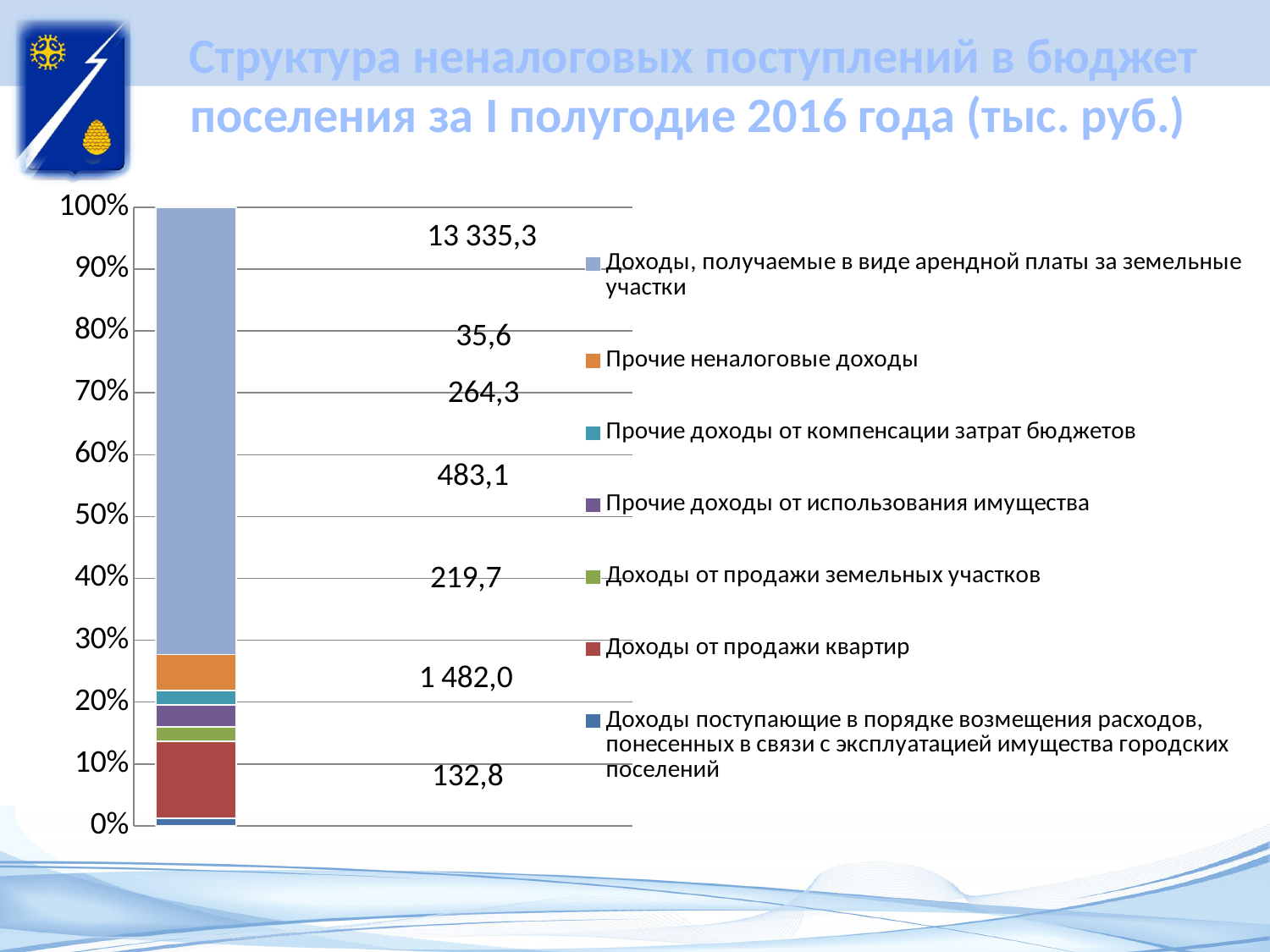
What is the total of all seven values printed on the chart? 15 952,8 Which legend entry is shown in orange? Прочие неналоговые доходы What is the difference between the values 1 482,0 and 132,8? 1 349,2 Which is larger: the value 1 482,0 or the value 483,1? 1 482,0 What value is printed for 'Прочие доходы от использования имущества'? 483,1 What is the largest value printed on the chart? 13 335,3 How many bars are plotted in the chart? 1 What kind of chart is shown on the slide? Stacked bar chart How many series does the legend list? 7 What value is printed for 'Доходы от продажи квартир'? 1 482,0 What value is printed for 'Доходы, получаемые в виде арендной платы за земельные участки'? 13 335,3 What is the smallest value printed on the chart? 35,6